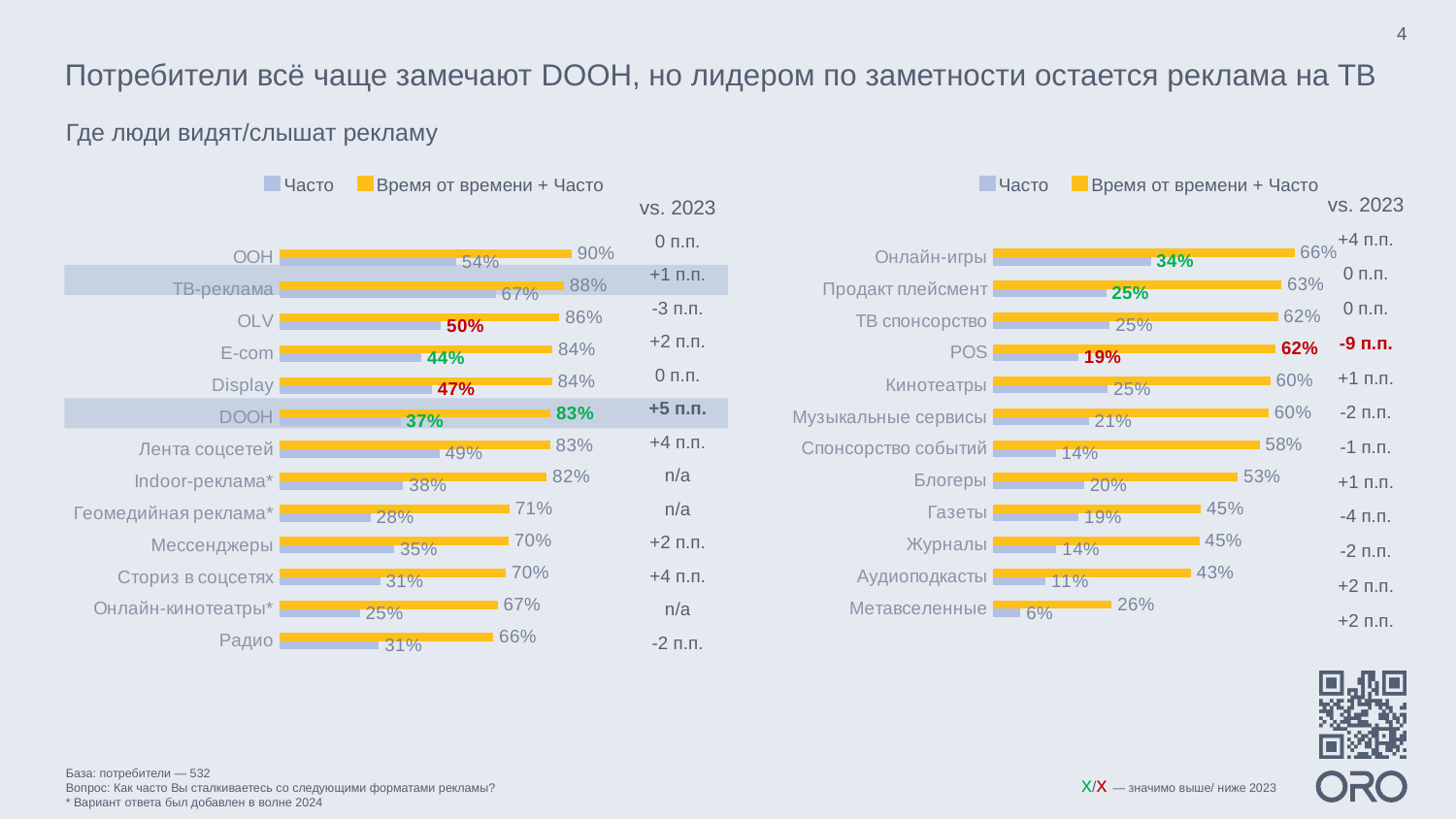
In the left chart, which category has the lowest 'Часто' value? Онлайн-кинотеатры* In the left chart, what is the 'Время от времени + Часто' value for OOH? 90% In the left chart, what is the difference between the 'Время от времени + Часто' value and the 'Часто' value for DOOH? 46 percentage points What type of chart is the right chart? Bar chart How many categories are shown in the right chart? 12 In the right chart, which category has the highest 'Время от времени + Часто' value? Онлайн-игры How many categories are shown in the left chart? 13 How many series does the legend of the left chart list? 2 In the left chart, what is the 'Часто' value for ТВ-реклама? 67% In the left chart, what is the 'vs. 2023' change shown for DOOH? +5 п.п. In the right chart, what is the 'Часто' value for Метавселенные? 6% In the right chart, which is larger: the 'Часто' value for Блогеры or for Газеты? Блогеры